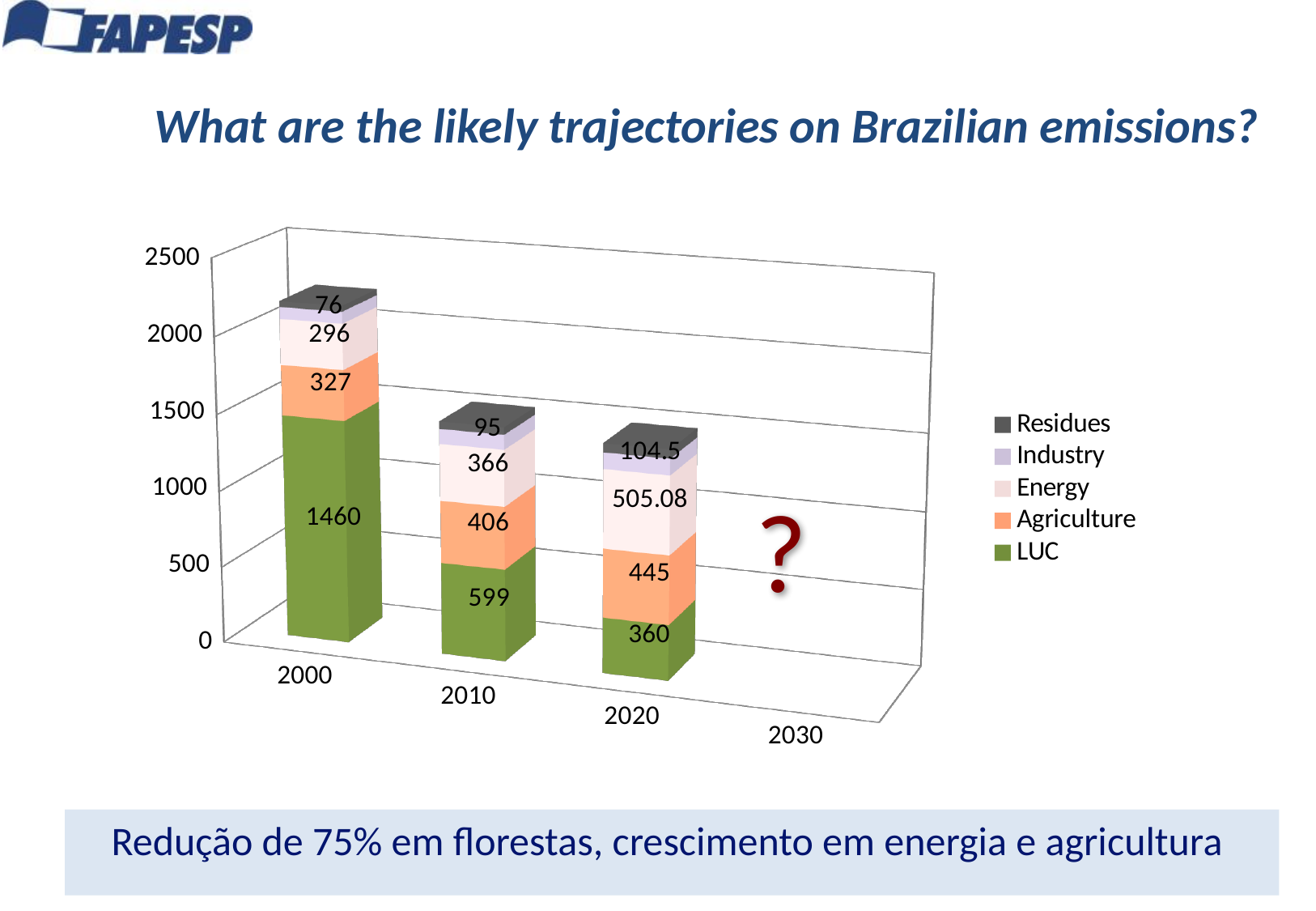
What is the difference between the LUC value in 2000 and in 2020? 1100 What kind of chart is shown on the slide? stacked bar chart What is the LUC value for 2000? 1460 In which year is the LUC value highest? 2000 Does the LUC value rise or fall from 2000 to 2020? fall How many series does the legend list? 5 In 2020, which is larger: the Energy value or the Agriculture value? Energy What is the Energy value for 2020? 505.08 In which year is the LUC value lowest? 2020 What is the Agriculture value for 2010? 406 How many years on the x axis have a bar plotted? 3